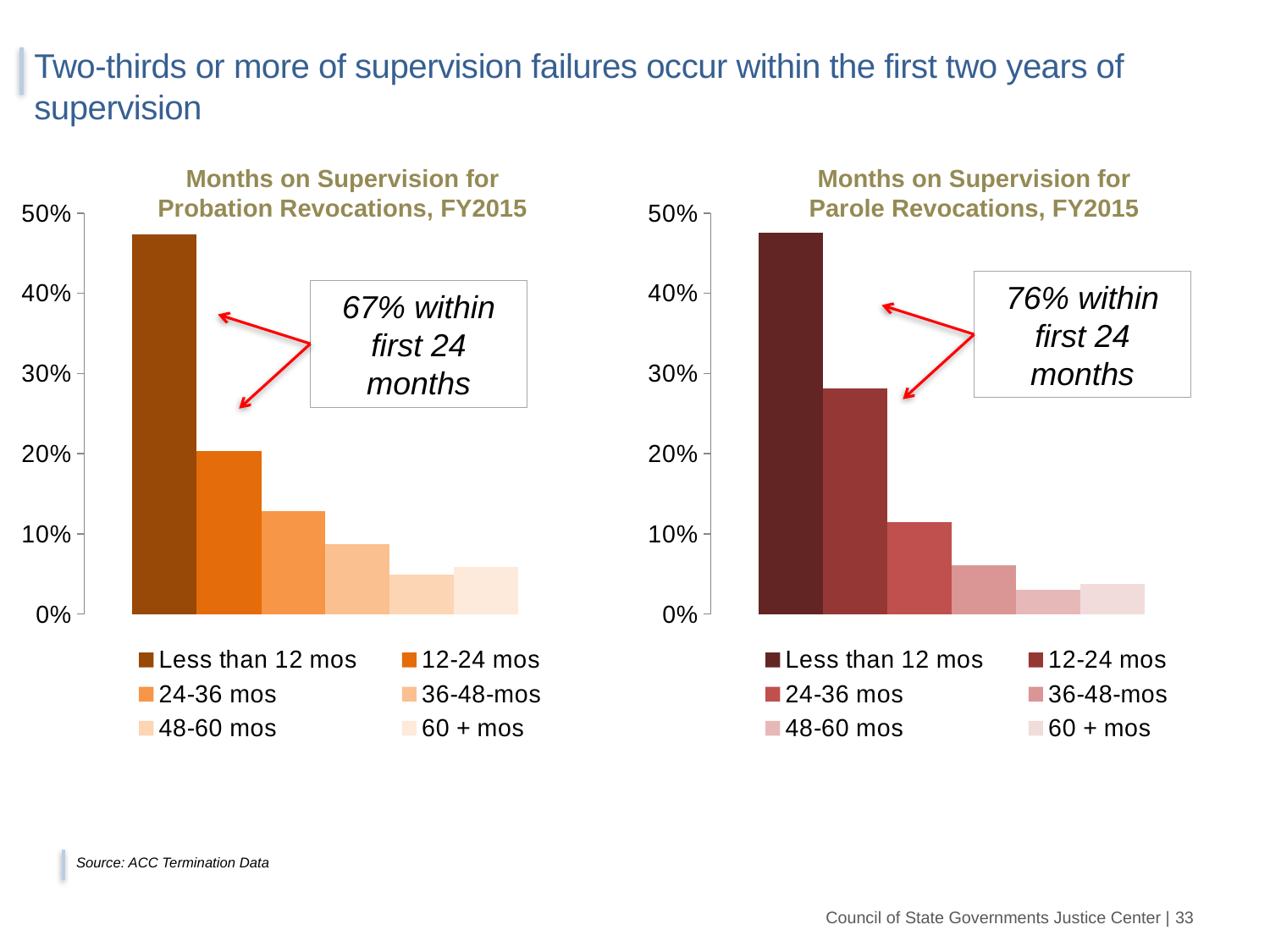
According to the annotation on the 'Months on Supervision for Probation Revocations, FY2015' chart, what share of probation revocations occur within the first 24 months? 67% In the 'Months on Supervision for Parole Revocations, FY2015' chart, is the value for 36-48-mos greater or less than 10%? less How many bars are plotted in the 'Months on Supervision for Probation Revocations, FY2015' chart? 6 What kind of chart is the 'Months on Supervision for Probation Revocations, FY2015' chart? bar chart In the 'Months on Supervision for Parole Revocations, FY2015' chart, is the value for 12-24 mos greater or less than 20%? greater In the 'Months on Supervision for Probation Revocations, FY2015' chart, which is larger: the value for 12-24 mos or the value for 24-36 mos? 12-24 mos In the 'Months on Supervision for Probation Revocations, FY2015' chart, is the value for 12-24 mos greater or less than 30%? less According to the annotation on the 'Months on Supervision for Parole Revocations, FY2015' chart, what share of parole revocations occur within the first 24 months? 76% In the 'Months on Supervision for Probation Revocations, FY2015' chart, which category has the highest value? Less than 12 mos How many categories does the legend of the 'Months on Supervision for Parole Revocations, FY2015' chart list? 6 In the 'Months on Supervision for Parole Revocations, FY2015' chart, which category has the highest value? Less than 12 mos